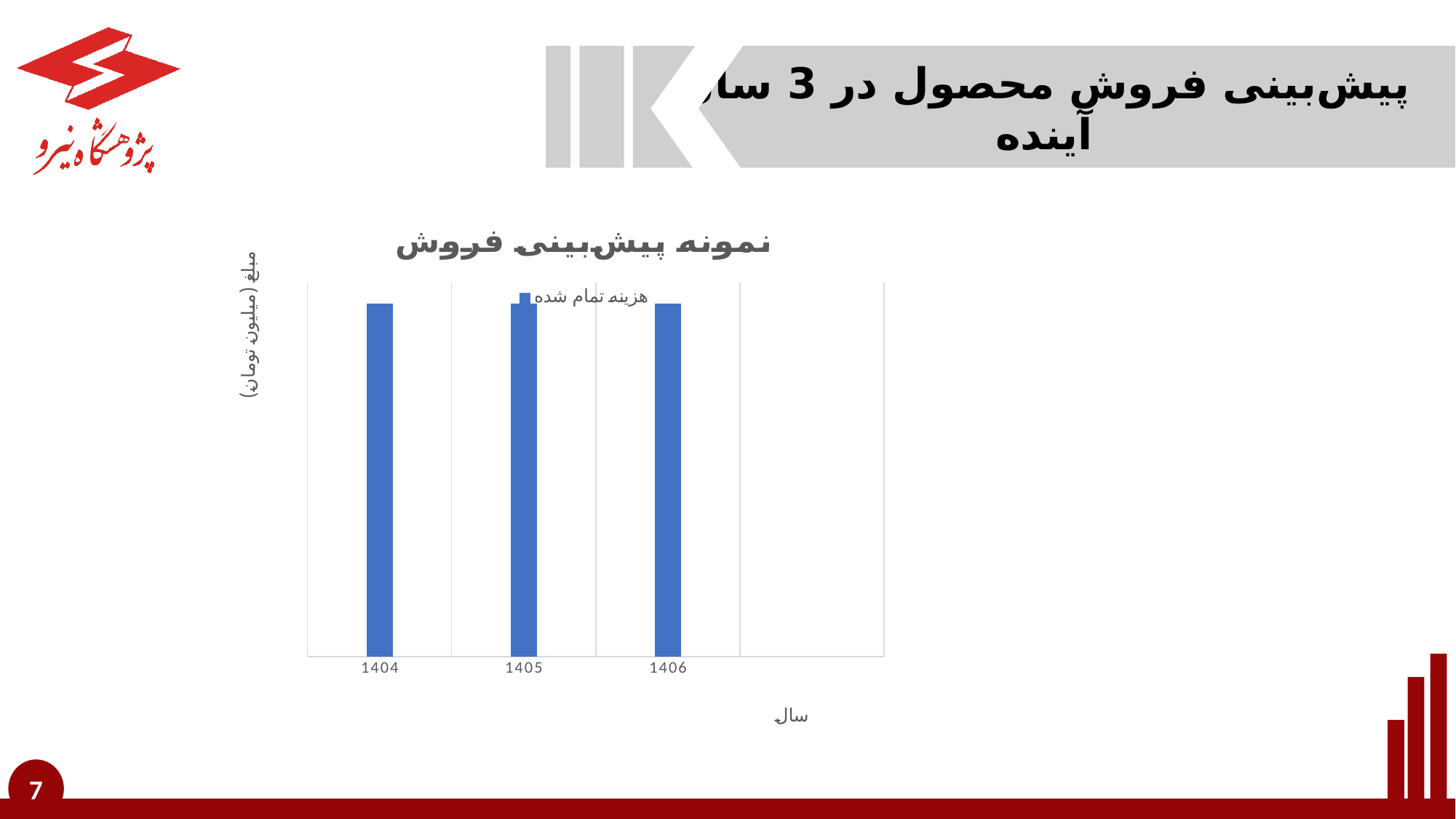
What is the last year category on the x axis? 1406 What is the first year category on the x axis? 1404 Which years are shown on the x axis of the chart? 1404, 1405, 1406 What kind of chart is shown on the slide? bar chart What is the title of the chart? نمونه پیش‌بینی فروش How many bars (years) are plotted in the chart? 3 What colour are the bars in the chart? blue